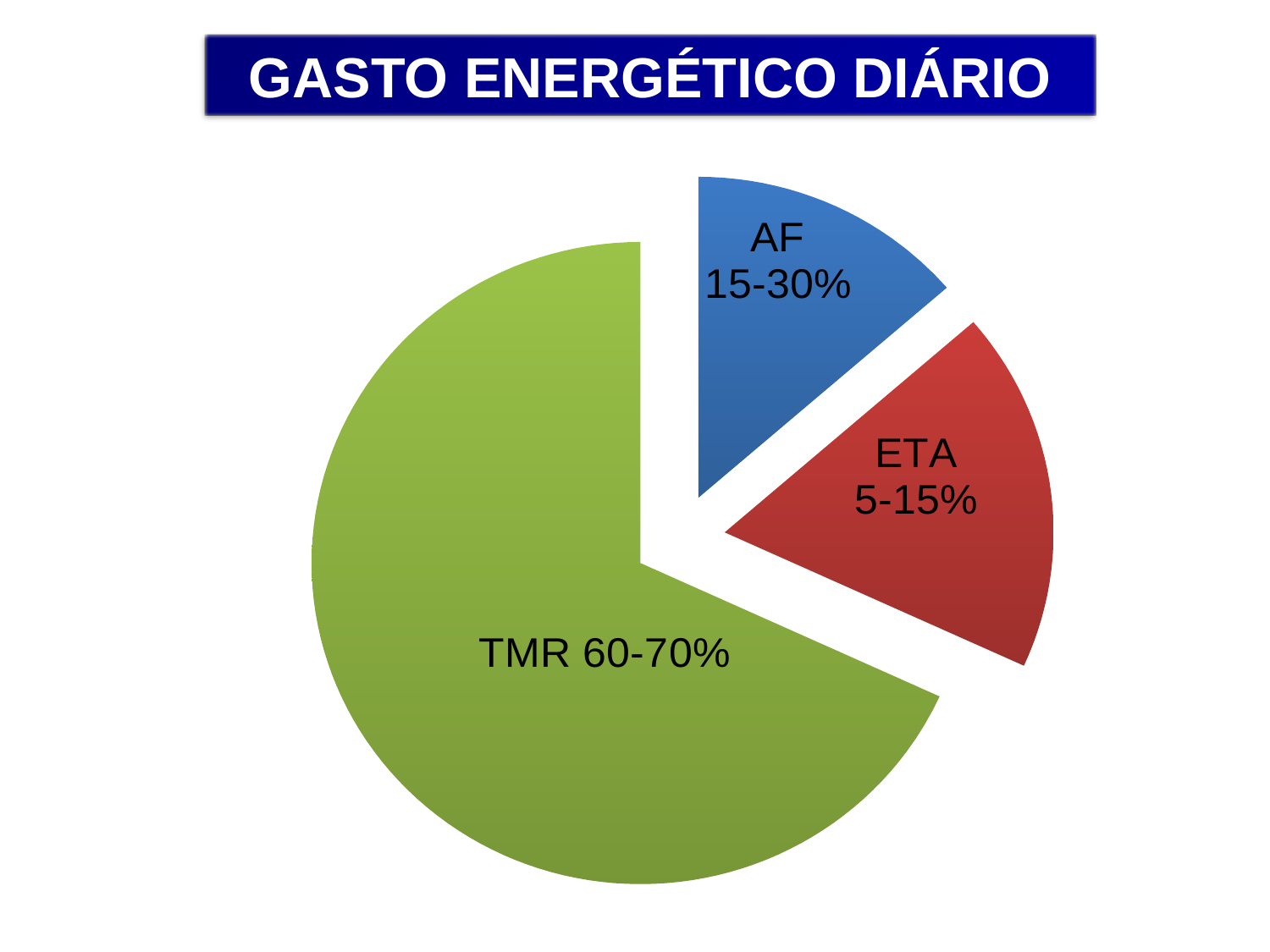
Which slice is coloured red? ETA What is the title of the chart? GASTO ENERGÉTICO DIÁRIO What percentage range is shown for the AF slice? 15-30% What percentage range is shown for the ETA slice? 5-15% How many slices does the pie chart have? 3 What colour is the TMR slice? green Which slice is the largest? TMR What kind of chart is shown on the slide? pie chart Which slice is larger, TMR or AF? TMR What percentage range is shown for the TMR slice? 60-70%